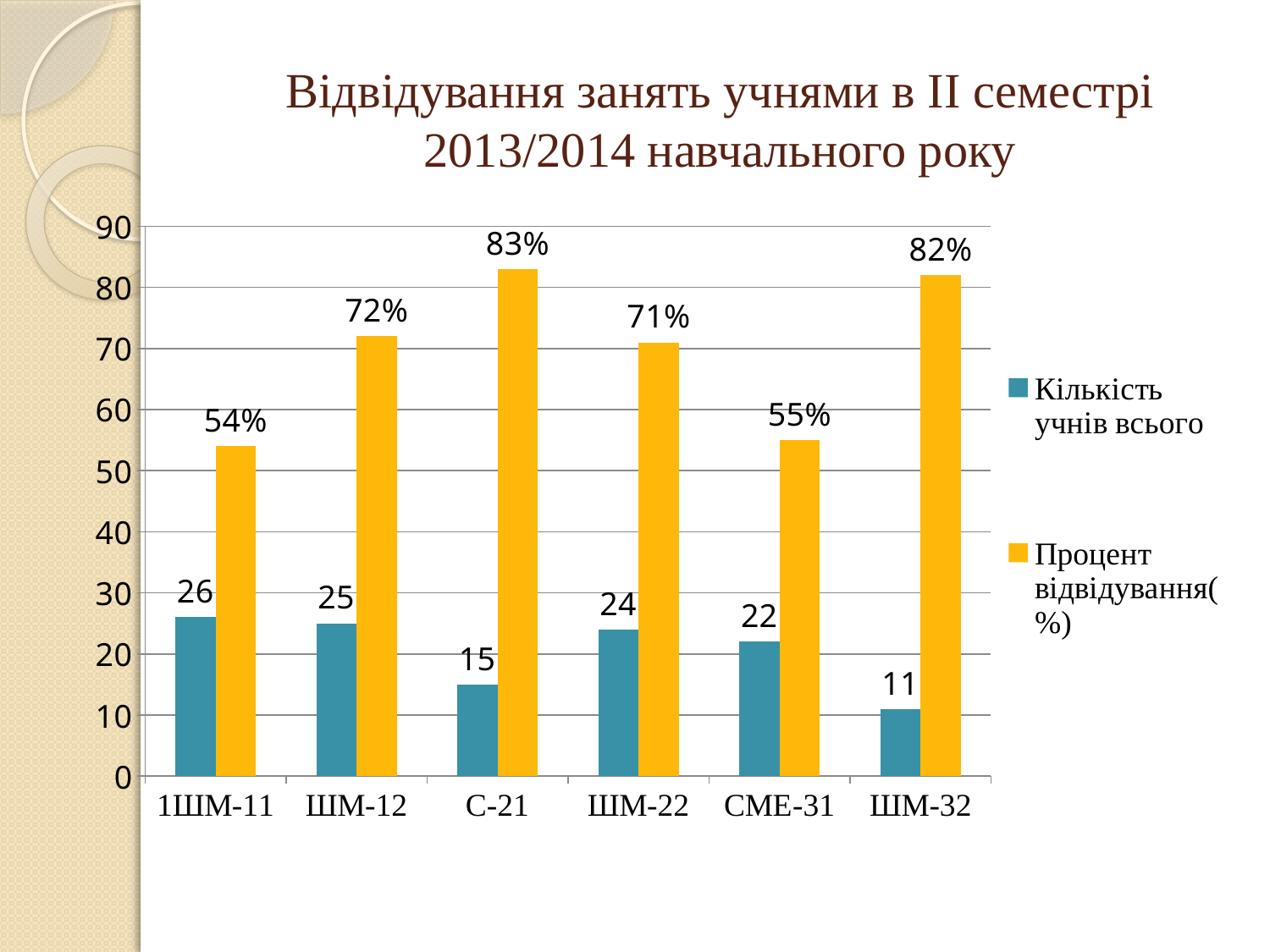
What is the value of "Кількість учнів всього" for 1ШМ-11? 26 What is the difference in "Кількість учнів всього" between 1ШМ-11 and ШМ-32? 15 Which has a higher "Процент відвідування(%)": ШМ-12 or СМЕ-31? ШМ-12 What is the "Процент відвідування(%)" value for ШМ-22? 71% Which category has the lowest "Процент відвідування(%)"? 1ШМ-11 What is the "Процент відвідування(%)" value for С-21? 83% What colour are the bars for "Процент відвідування(%)"? Yellow/orange How many categories are shown on the x axis? 6 How many series does the legend list? 2 Which category has the lowest "Кількість учнів всього"? ШМ-32 What kind of chart is shown on the slide? Bar chart Which category has the highest "Процент відвідування(%)"? С-21